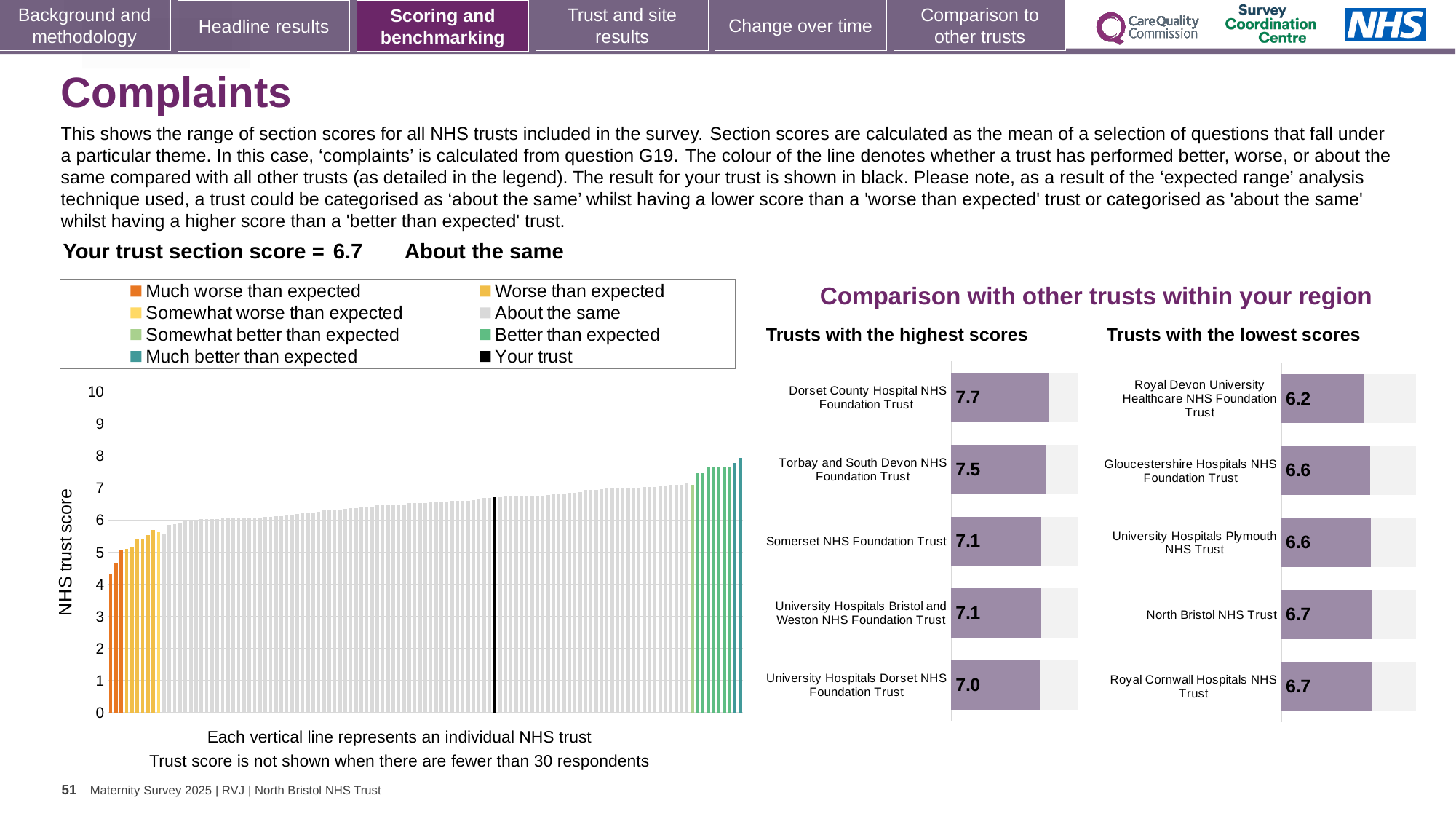
In the 'Trusts with the highest scores' chart, which trust has the highest score? Dorset County Hospital NHS Foundation Trust In the 'Trusts with the lowest scores' chart, what is the score for Royal Cornwall Hospitals NHS Trust? 6.7 What kind of chart is the main chart showing NHS trust scores on the left of the slide? Bar chart In the 'Trusts with the highest scores' chart, what is the score for Torbay and South Devon NHS Foundation Trust? 7.5 In the 'Trusts with the lowest scores' chart, which trust has the lowest score? Royal Devon University Healthcare NHS Foundation Trust In the 'Trusts with the lowest scores' chart, what is the score for Royal Devon University Healthcare NHS Foundation Trust? 6.2 In the 'Trusts with the lowest scores' chart, which has the larger score: Gloucestershire Hospitals NHS Foundation Trust or Royal Devon University Healthcare NHS Foundation Trust? Gloucestershire Hospitals NHS Foundation Trust In the main NHS trust score chart, do the bar values rise or fall from left to right? Rise How many entries does the legend of the main NHS trust score chart list? 8 In the 'Trusts with the highest scores' chart, what is the difference between the scores of Dorset County Hospital NHS Foundation Trust and University Hospitals Dorset NHS Foundation Trust? 0.7 How many trusts are shown in the 'Trusts with the lowest scores' chart? 5 In the 'Trusts with the highest scores' chart, what is the score for Dorset County Hospital NHS Foundation Trust? 7.7